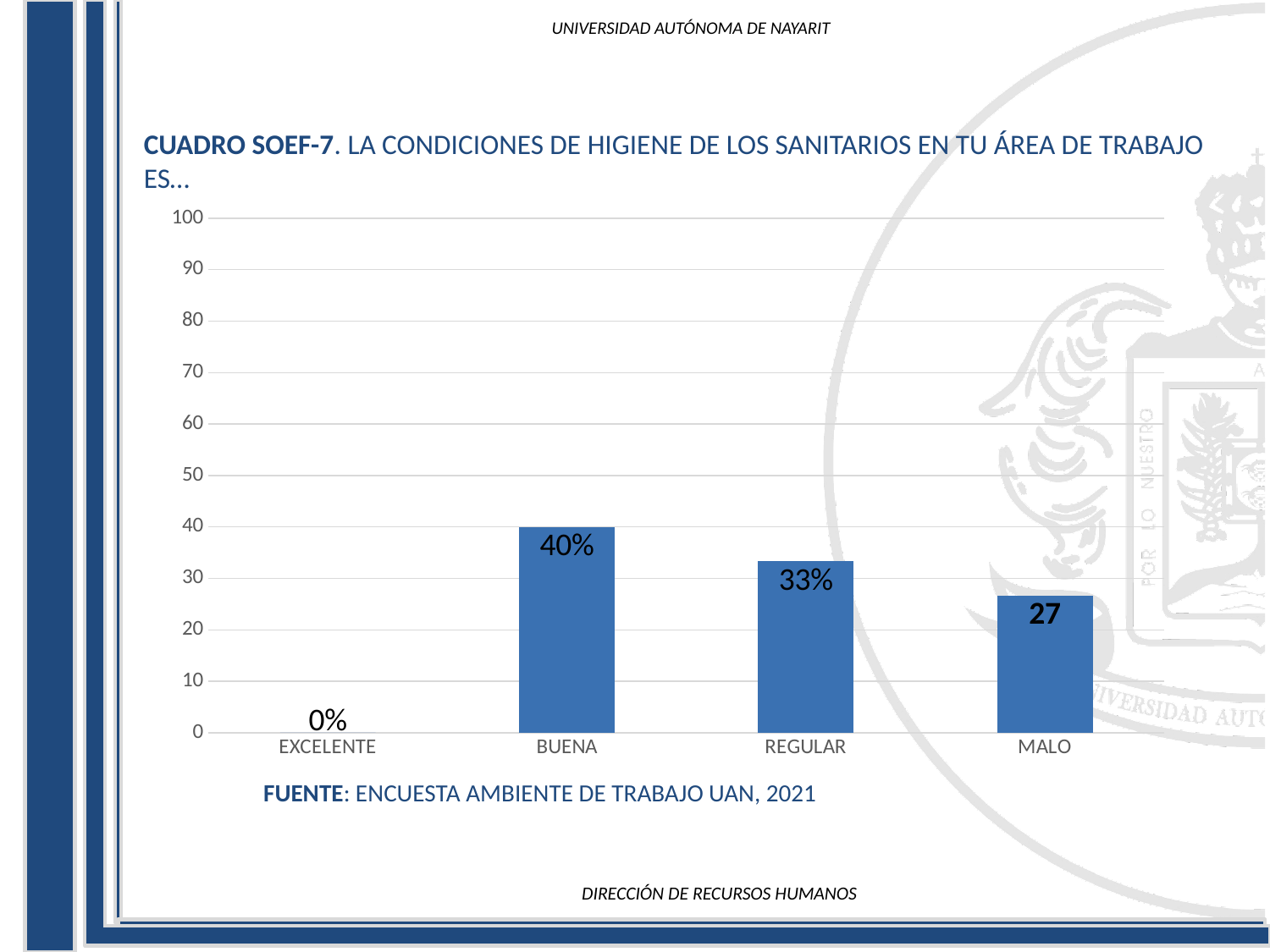
What is the value shown for MALO? 27 What kind of chart is shown on the slide? bar chart What is the value for BUENA? 40% What source is cited below the chart? ENCUESTA AMBIENTE DE TRABAJO UAN, 2021 What is the value for EXCELENTE? 0% Is the value for BUENA greater or less than 50? less What is the value for REGULAR? 33% Which is larger, the value for REGULAR or the value for MALO? REGULAR Which category has the lowest value? EXCELENTE What is the difference between the values for BUENA and REGULAR? 7 Which category has the highest value? BUENA How many categories are shown on the x axis? 4